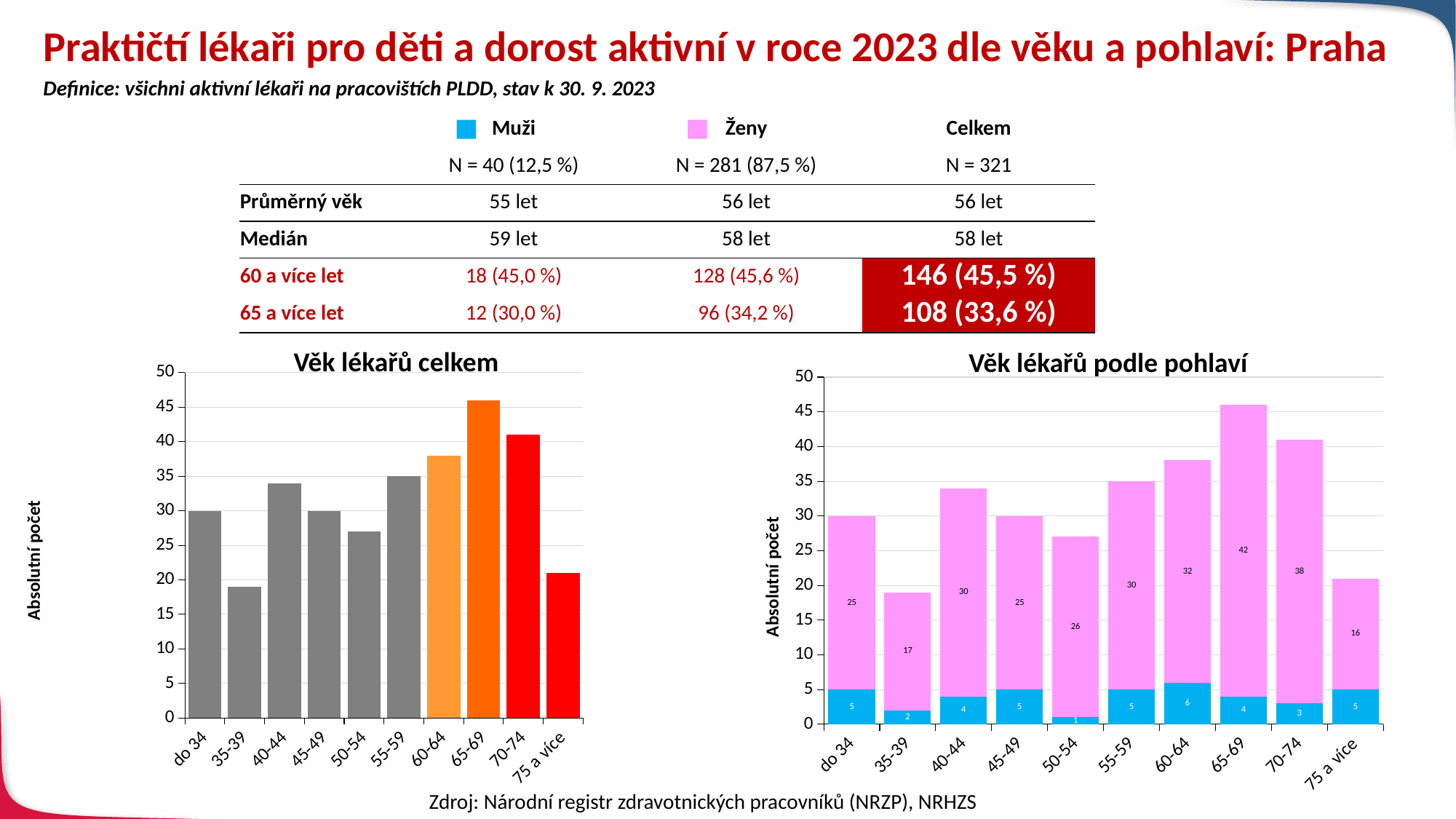
In the chart 'Věk lékařů podle pohlaví', what is the difference between the Ženy values for 65-69 and 70-74? 4 In the chart 'Věk lékařů podle pohlaví', which age group has the highest value for Ženy? 65-69 How many series does the legend list for the chart 'Věk lékařů podle pohlaví'? 2 In the chart 'Věk lékařů podle pohlaví', which age group has the lowest value for Muži? 50-54 In the chart 'Věk lékařů podle pohlaví', what is the value for Muži in the 50-54 age group? 1 In the chart 'Věk lékařů celkem', which age group has the lowest bar? 35-39 In the chart 'Věk lékařů podle pohlaví', what is the total of the stacked bar for the 65-69 age group? 46 In the chart 'Věk lékařů podle pohlaví', what is the total of the stacked bar for the 35-39 age group? 19 In the chart 'Věk lékařů podle pohlaví', what is the value for Ženy in the 65-69 age group? 42 In the chart 'Věk lékařů celkem', which age group has the highest bar? 65-69 In the chart 'Věk lékařů celkem', is the value for 60-64 greater or less than 35? greater How many age groups are shown on the x axis of the chart 'Věk lékařů celkem'? 10